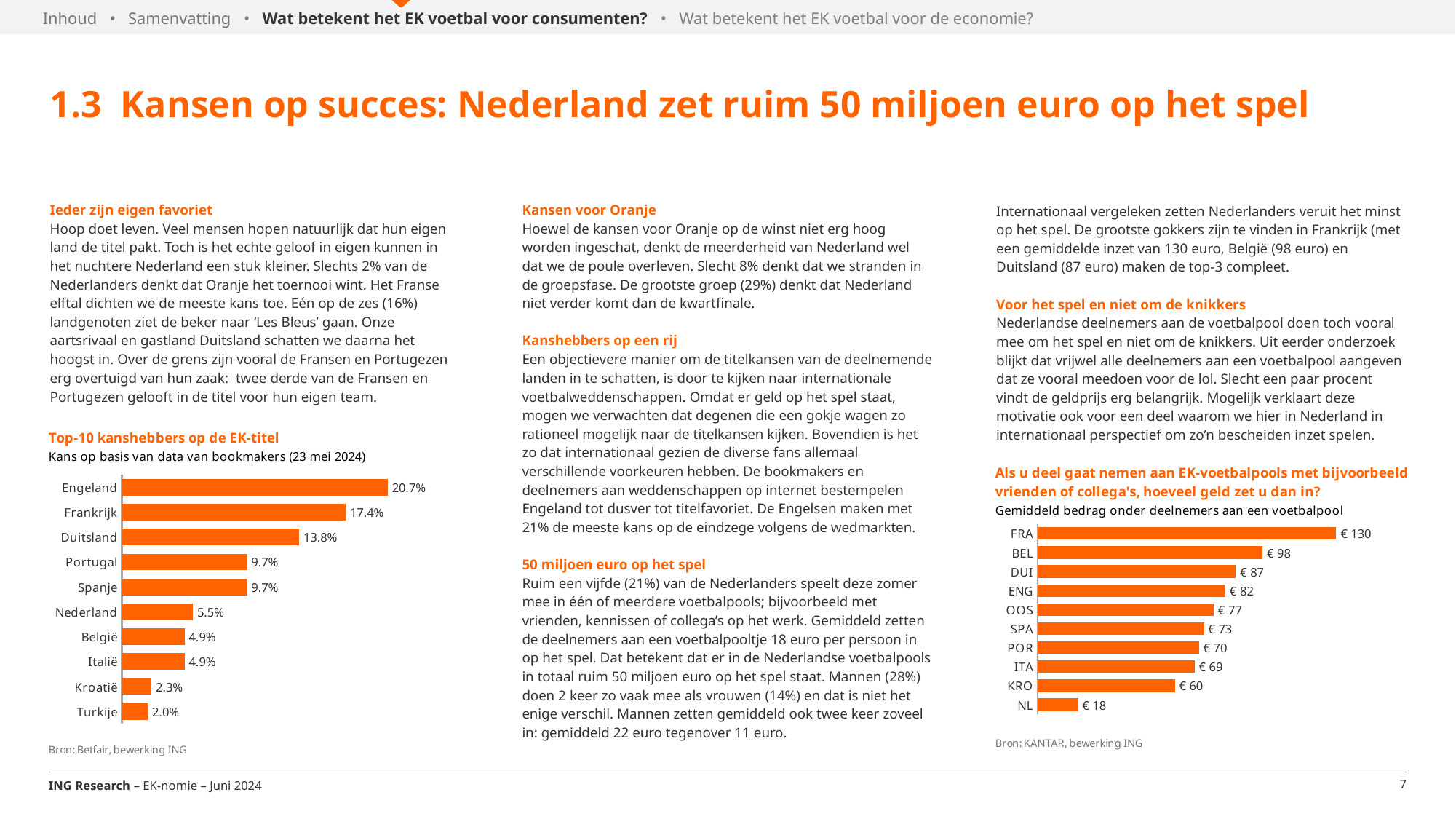
In the 'Top-10 kanshebbers op de EK-titel' chart, what is the difference between Engeland and Frankrijk? 3.3% In the 'Top-10 kanshebbers op de EK-titel' chart, how many countries are shown? 10 In the chart on the right about EK-voetbalpools, what is the average amount for FRA? € 130 In the 'Top-10 kanshebbers op de EK-titel' chart, what is the value for Nederland? 5.5% In the 'Top-10 kanshebbers op de EK-titel' chart, which country has the lowest value? Turkije In the chart on the right about EK-voetbalpools, which country has the highest average amount? FRA In the 'Top-10 kanshebbers op de EK-titel' chart, what is the value for Engeland? 20.7% In the chart on the right about EK-voetbalpools, what is the difference between BEL and KRO? € 38 In the chart on the right about EK-voetbalpools, what is the average amount for NL? € 18 What kind of chart is the 'Top-10 kanshebbers op de EK-titel' chart? Bar chart What is the source given below the 'Top-10 kanshebbers op de EK-titel' chart? Betfair, bewerking ING In the chart on the right about EK-voetbalpools, which is larger: the value for DUI or the value for ENG? DUI